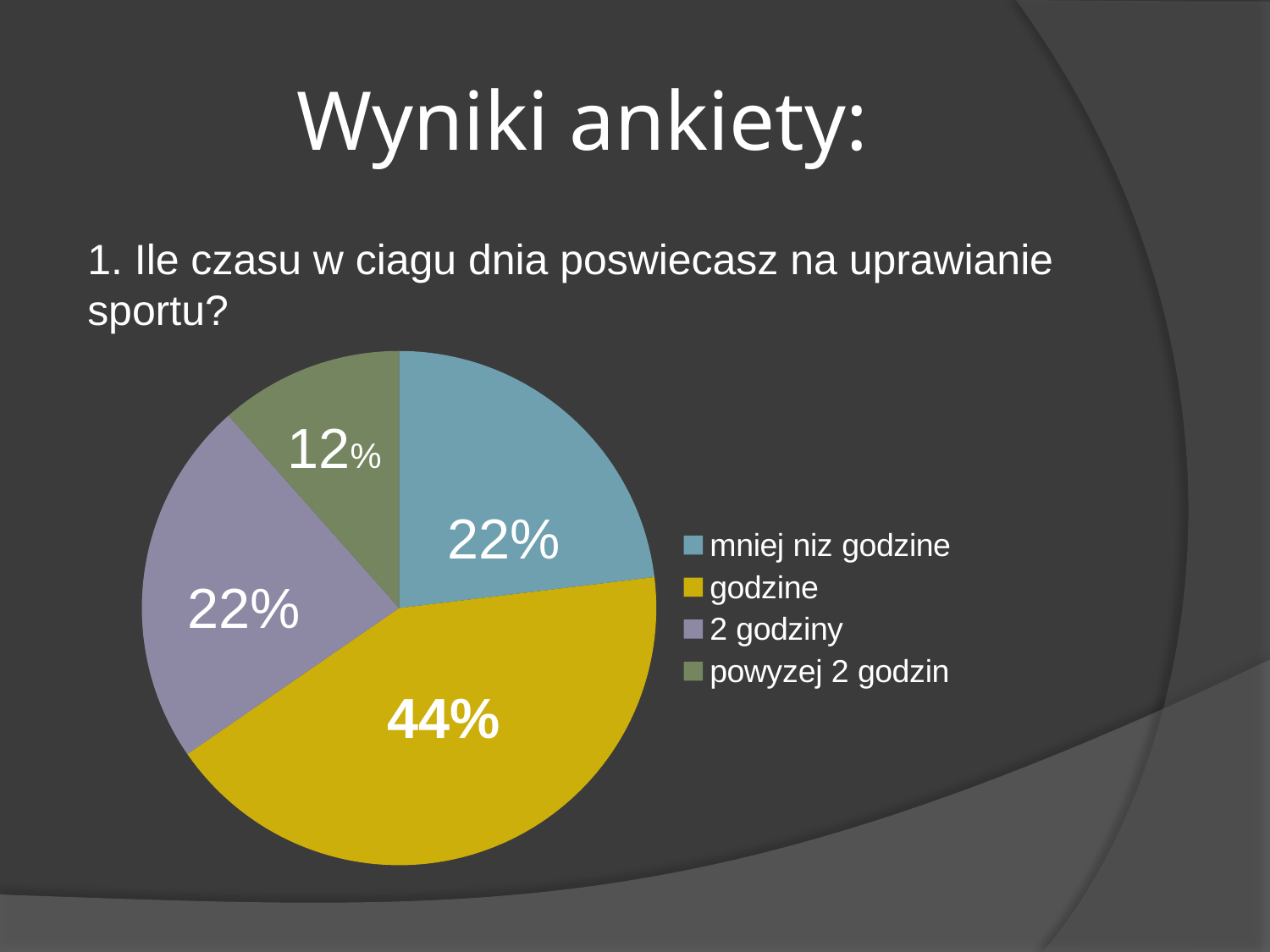
What share of the pie does "2 godziny" have? 22% How many categories does the pie chart have? 4 Which category has the largest slice of the pie? godzine What is the difference between the share for "godzine" and the share for "powyzej 2 godzin"? 32% What share of the pie does "powyzej 2 godzin" have? 12% Which category has the smallest slice of the pie? powyzej 2 godzin Which is larger, the share for "godzine" or the share for "2 godziny"? godzine What share of the pie does "mniej niz godzine" have? 22% What kind of chart is shown on the slide? pie chart What colour is the slice for "godzine"? yellow What is the difference between the share for "mniej niz godzine" and the share for "powyzej 2 godzin"? 10%